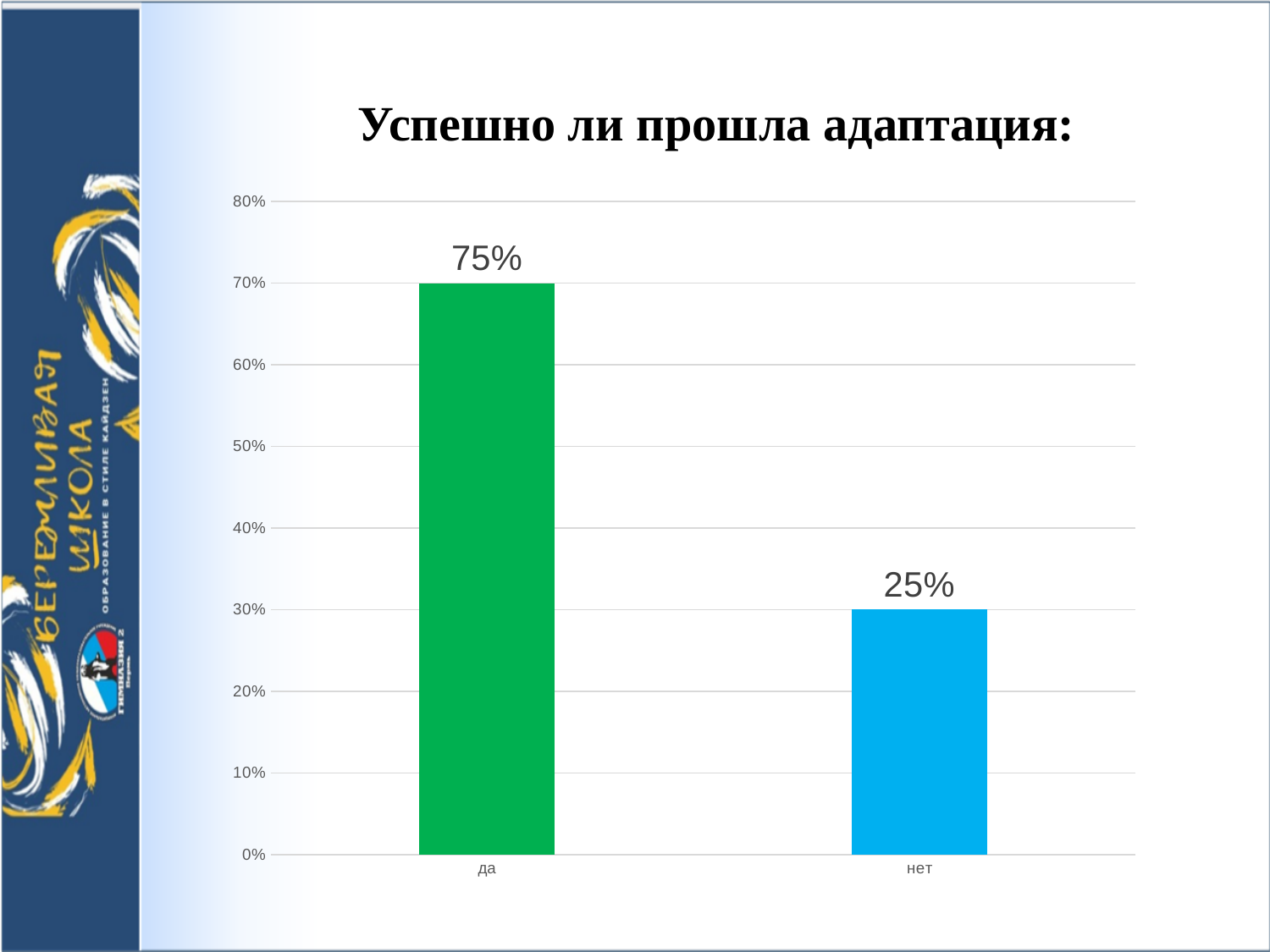
What kind of chart is shown on the slide? bar chart Which category has the lowest value? нет How many categories are shown on the x axis? 2 Is the value for "да" greater or less than 60%? greater Is the value for "нет" greater or less than 40%? less What colour is the bar for "нет"? blue Which is larger, the value for "да" or the value for "нет"? да Which category has the highest value? да What value is shown for the category "да"? 75% What is the title of the chart? Успешно ли прошла адаптация: What value is shown for the category "нет"? 25%